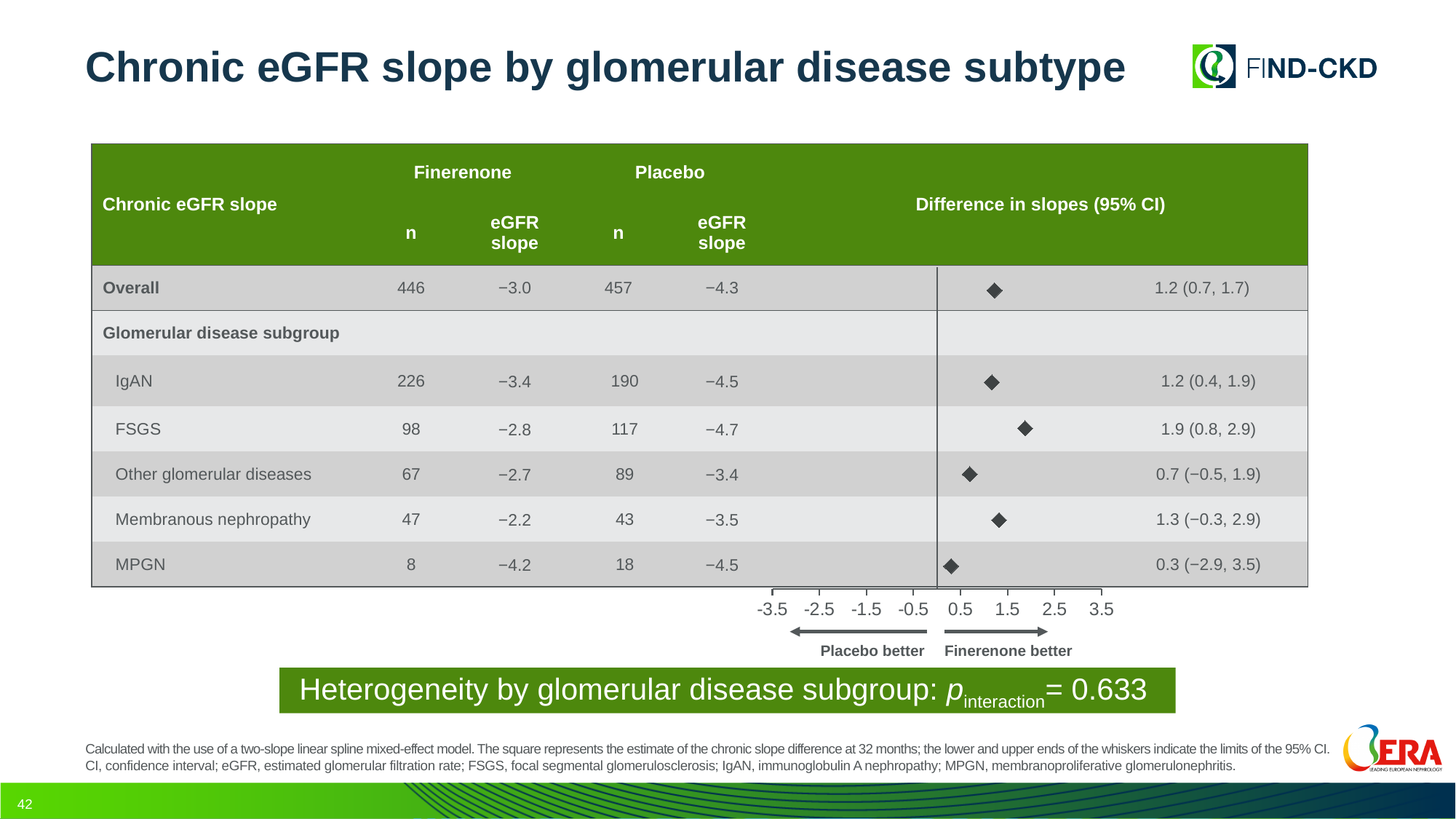
What does the right-pointing arrow below the axis indicate? Finerenone better How many rows have a point estimate plotted in the forest plot? 6 Which glomerular disease subgroup has the highest point estimate for the difference in slopes? FSGS What is the difference in slopes (95% CI) for FSGS? 1.9 (0.8, 2.9) Is the point estimate for FSGS greater or less than 1.5? greater Which has a larger point estimate for the difference in slopes: Membranous nephropathy or Other glomerular diseases? Membranous nephropathy What kind of chart is shown in the Difference in slopes column? Forest plot What is the difference between the point estimates for FSGS and MPGN? 1.6 Which glomerular disease subgroup has the lowest point estimate for the difference in slopes? MPGN What is the difference in slopes (95% CI) for MPGN? 0.3 (−2.9, 3.5) What is the point estimate of the difference in slopes for Membranous nephropathy? 1.3 What is the difference in slopes (95% CI) for the Overall group? 1.2 (0.7, 1.7)